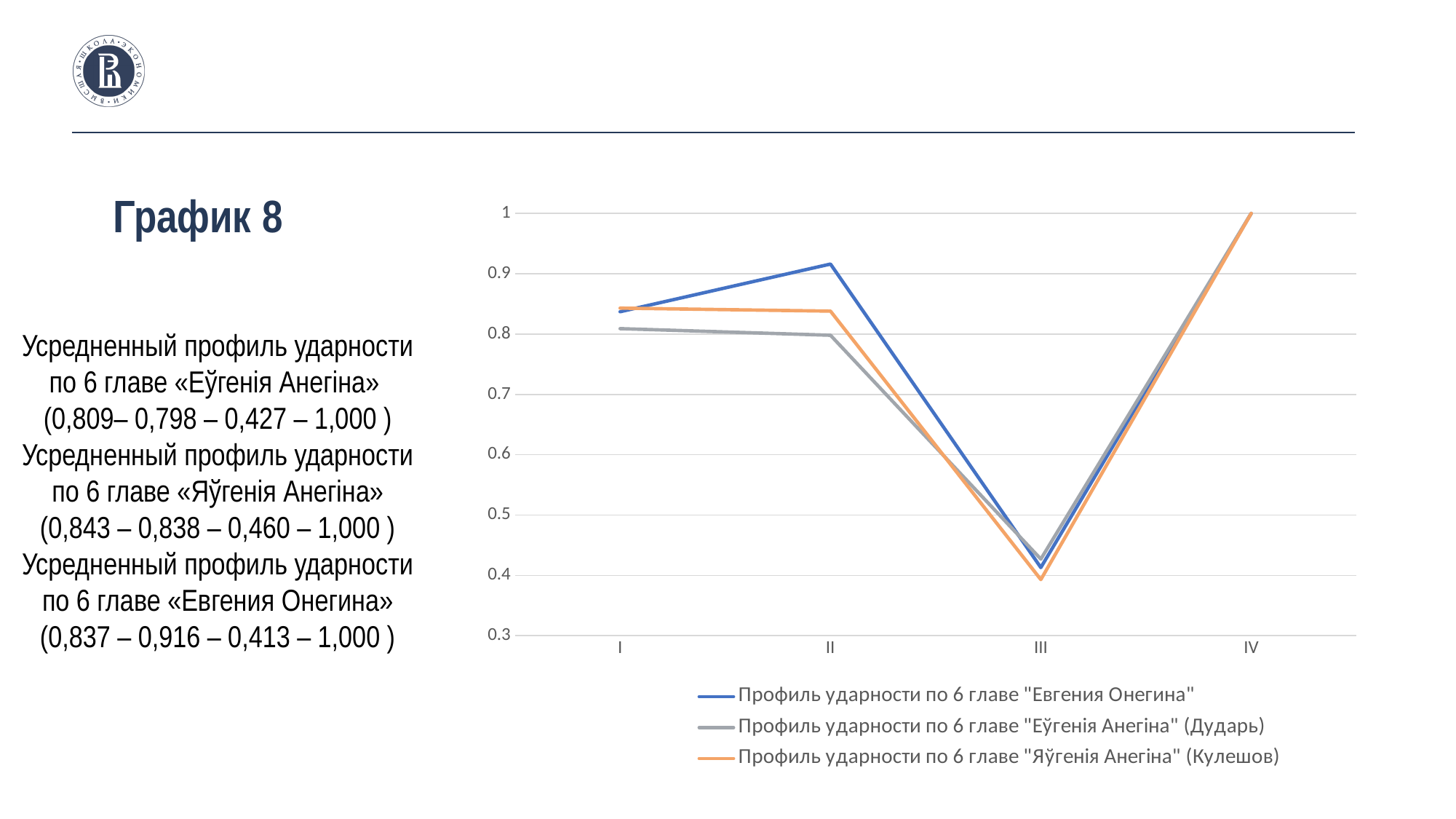
Is the value for "Евгения Онегина" at point II greater or less than 0.9? greater How many series does the legend of the chart list? 3 According to the text on the slide, what is the difference between the second values of the «Евгения Онегина» profile (0,916) and the «Еўгенія Анегіна» profile (0,798)? 0,118 What colour is the line for "Профиль ударности по 6 главе "Евгения Онегина"" in the chart? blue According to the text on the slide, what is the value of the averaged profile for «Евгения Онегина» at the second point? 0,916 Do the values of the series "Евгения Онегина" rise or fall from point II to point III? fall At point II, which series has the larger value: "Евгения Онегина" or "Еўгенія Анегіна" (Дударь)? Евгения Онегина What kind of chart is shown on the slide? line chart How many points are there along the x axis of the chart? 4 At which x-axis point does the series "Евгения Онегина" reach its lowest value? III At which x-axis point does the series "Евгения Онегина" reach its highest value? IV Is the value for "Еўгенія Анегіна" (Дударь) at point III greater or less than 0.5? less